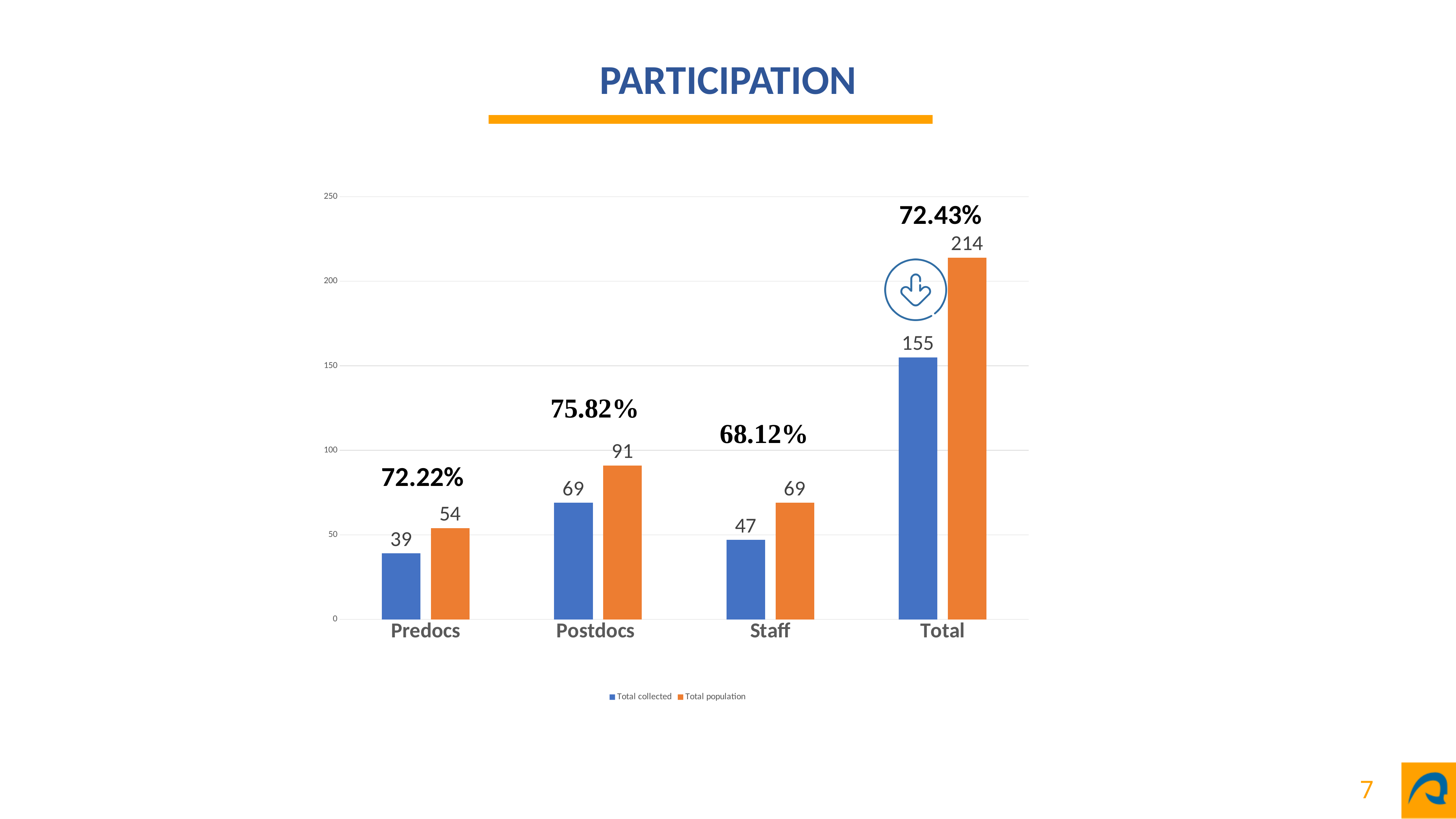
What participation percentage is shown above the Staff bars? 68.12% What is the Total collected value for Predocs? 39 Which category has the highest Total collected value? Total How many series does the legend list? 2 What is the difference between Total population and Total collected for Postdocs? 22 Among Predocs, Postdocs and Staff, which has the lowest Total population value? Predocs What is the Total population value for the Total category? 214 Which is larger, the Total collected value for Postdocs or for Staff? Postdocs What kind of chart is shown on the slide? Bar chart What is the Total population value for Postdocs? 91 How many categories are shown on the x axis? 4 What is the Total collected value for Staff? 47